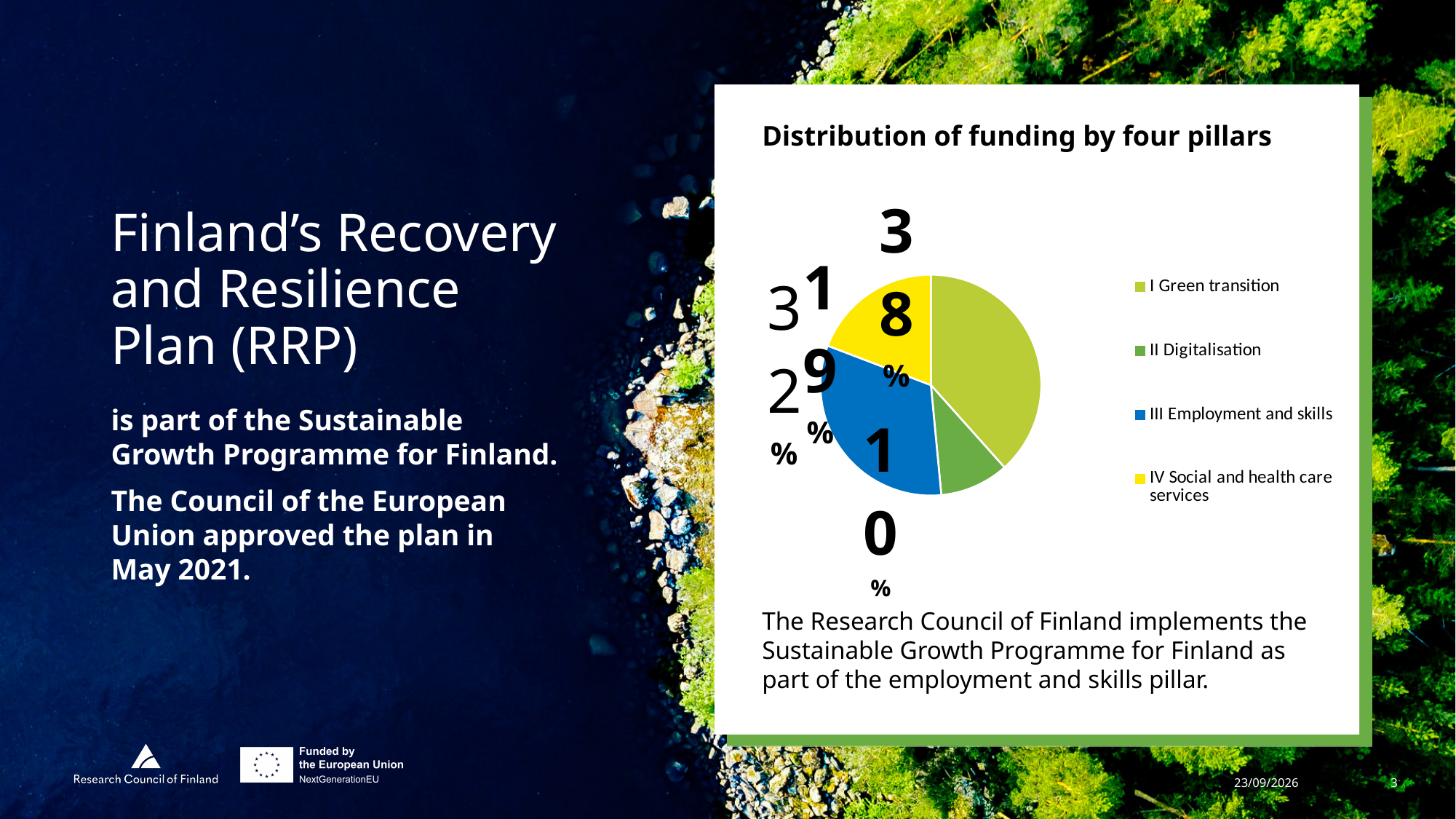
Which colour represents IV Social and health care services in the pie chart? yellow Which pillar is shown in blue in the pie chart? III Employment and skills How many entries does the chart legend list? 4 Which pillar has the smallest share of funding in the pie chart? II Digitalisation Which has a larger share of funding, I Green transition or IV Social and health care services? I Green transition Which has a larger share of funding, I Green transition or II Digitalisation? I Green transition What kind of chart is shown on the slide? pie chart Which has a larger share of funding, III Employment and skills or II Digitalisation? III Employment and skills Which pillar has the largest share of funding in the pie chart? I Green transition How many slices does the pie chart have? 4 What is the title of the chart? Distribution of funding by four pillars